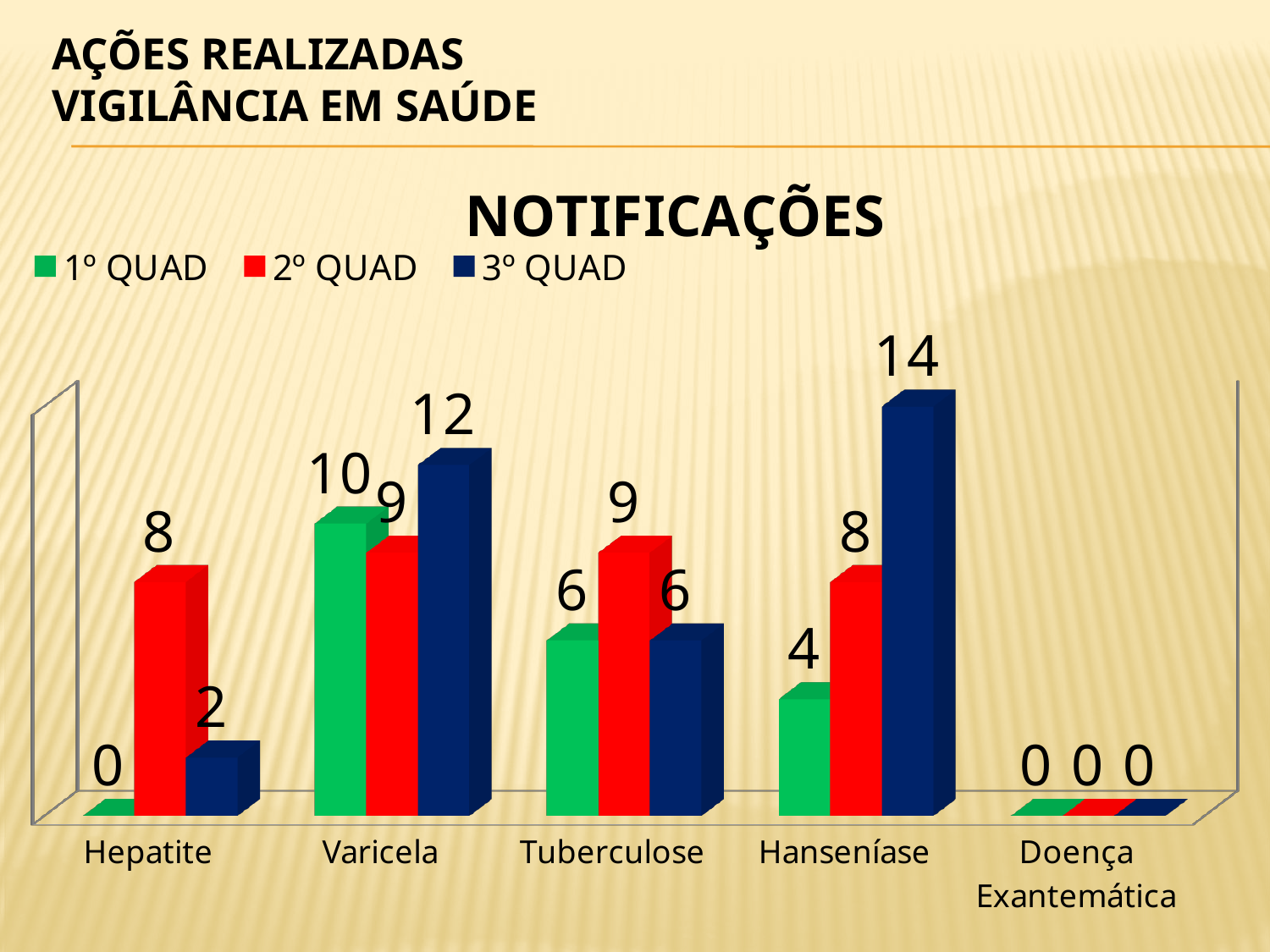
How many series does the legend list? 3 Which is larger for Varicela: the 2º QUAD value or the 3º QUAD value? 3º QUAD Which category has the highest value in the 3º QUAD series? Hanseníase What is the value for Varicela in the 1º QUAD series? 10 Which category has the lowest value in the 2º QUAD series? Doença Exantemática What is the value for Tuberculose in the 2º QUAD series? 9 What is the title of the chart? NOTIFICAÇÕES What kind of chart is shown on the slide? Bar chart What is the difference between the 3º QUAD and 1º QUAD values for Hanseníase? 10 How many categories are shown on the x axis? 5 What is the value for Hepatite in the 2º QUAD series? 8 What is the value for Hanseníase in the 3º QUAD series? 14